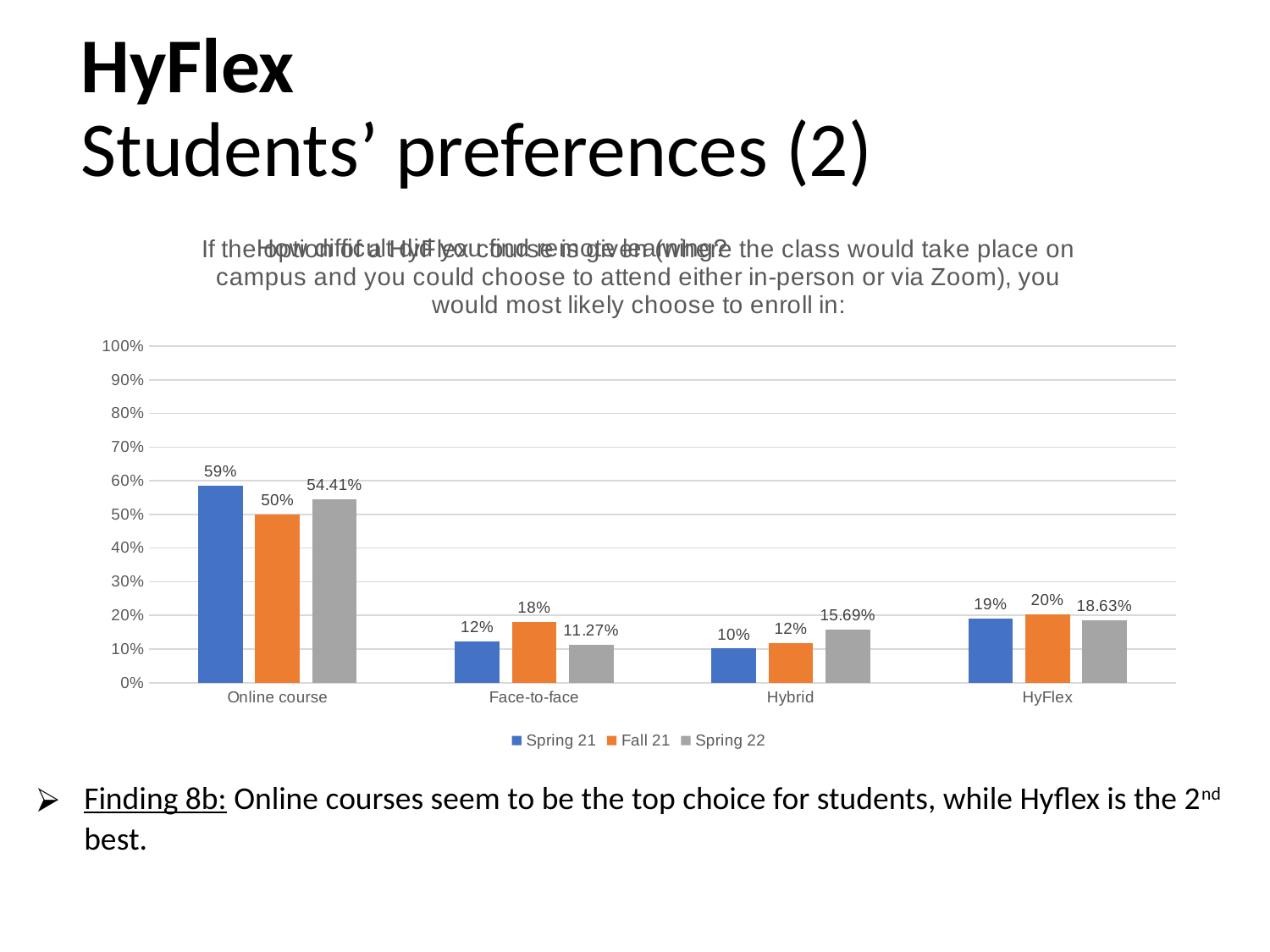
What is the value for Online course in the Spring 21 series? 59% How many categories are shown on the x axis? 4 Is the Spring 22 value for Online course greater or less than 50%? greater What is the value for HyFlex in the Spring 22 series? 18.63% Which category has the highest value in the Fall 21 series? Online course How many series does the legend list? 3 What is the value for Hybrid in the Spring 22 series? 15.69% Which is larger for Face-to-face: the Fall 21 value or the Spring 22 value? Fall 21 What is the value for Face-to-face in the Fall 21 series? 18% Which category has the lowest value in the Spring 21 series? Hybrid What is the difference between the Spring 21 and Fall 21 values for Online course? 9% What kind of chart is shown on the slide? bar chart